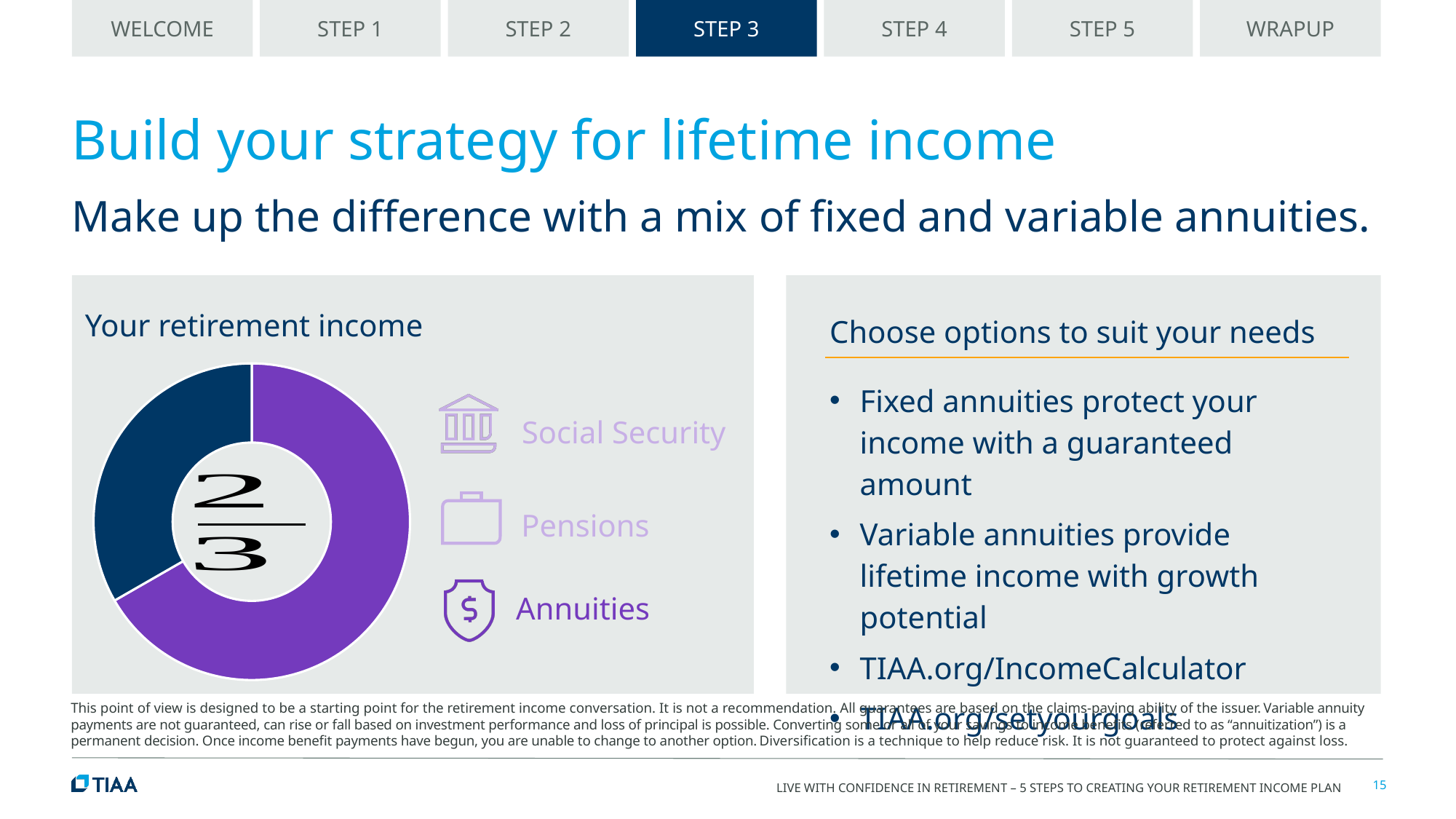
Which category takes up the largest portion of the "Your retirement income" donut chart? Annuities How many entries does the legend next to the "Your retirement income" chart list? 3 How many distinct colored segments are visible in the "Your retirement income" donut chart? 2 What fraction is printed in the center of the "Your retirement income" donut chart? 2/3 What color represents Annuities in the "Your retirement income" chart? Purple What kind of chart is shown under "Your retirement income"? Pie chart (donut) Is the Annuities share of the "Your retirement income" chart greater or less than 50%? greater In the "Your retirement income" chart, which is larger: the purple segment or the dark navy segment? The purple segment Which legend entry in the "Your retirement income" chart is shown with a shield and dollar-sign icon? Annuities What is the title of the chart on the left of the slide? Your retirement income